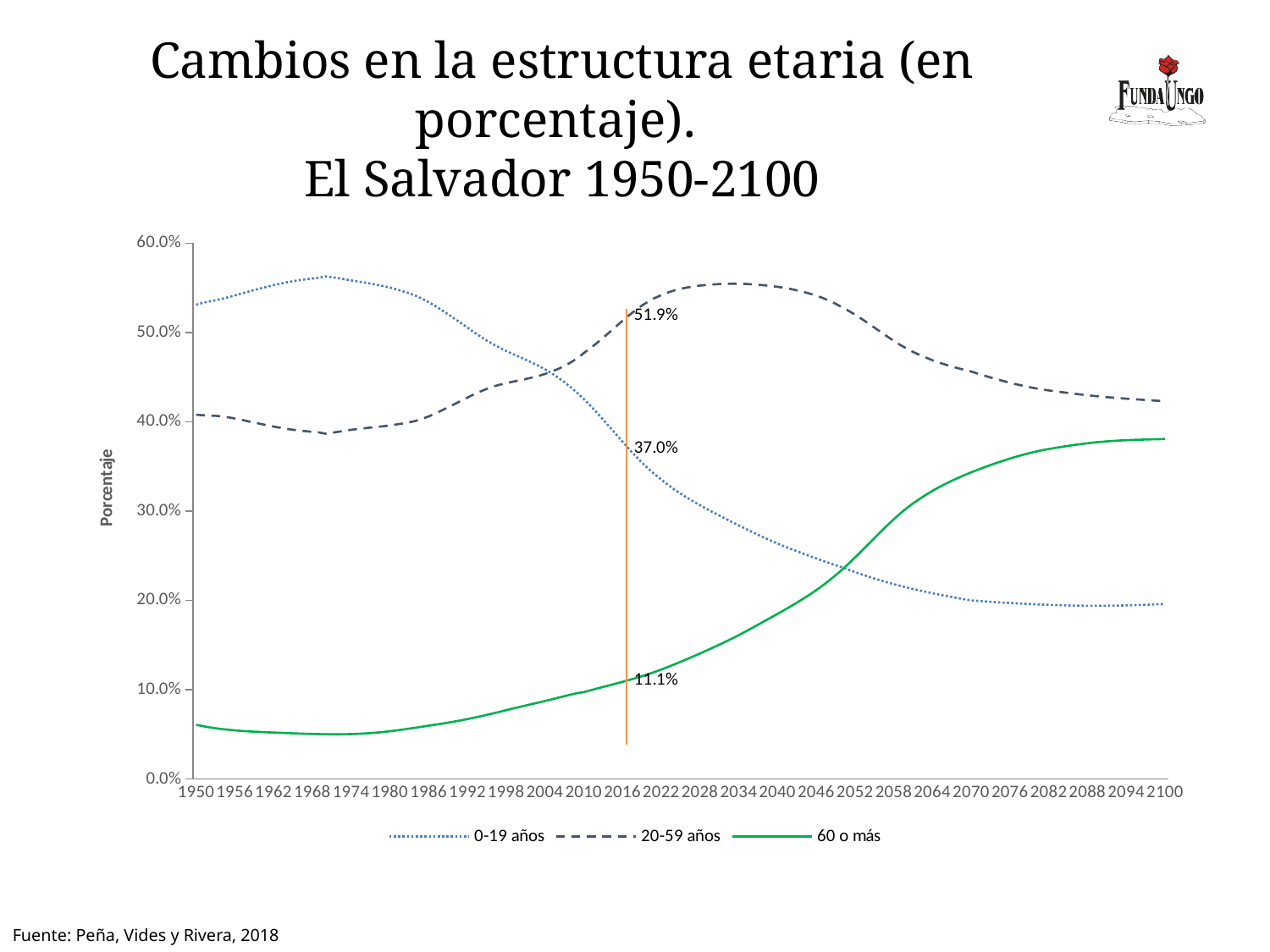
At the 2016 marker, what is the difference between the 20-59 años value and the 0-19 años value? 14.9 percentage points Does the 60 o más series rise or fall from 1950 to 2100? rise At the 2016 marker, which series has the lowest value? 60 o más What is the value for the 60 o más series at the 2016 marker? 11.1% How many series does the legend list? 3 Is the value for 60 o más in 2100 greater or less than 30.0%? greater At the 2016 marker, which series has the highest value? 20-59 años Is the value for 0-19 años in 1950 greater or less than 50.0%? greater At the 2016 marker, what is the difference between the 0-19 años value and the 60 o más value? 25.9 percentage points What kind of chart is shown on the slide? line chart What is the value for the 0-19 años series at the 2016 marker? 37.0% What is the value for the 20-59 años series at the 2016 marker? 51.9%